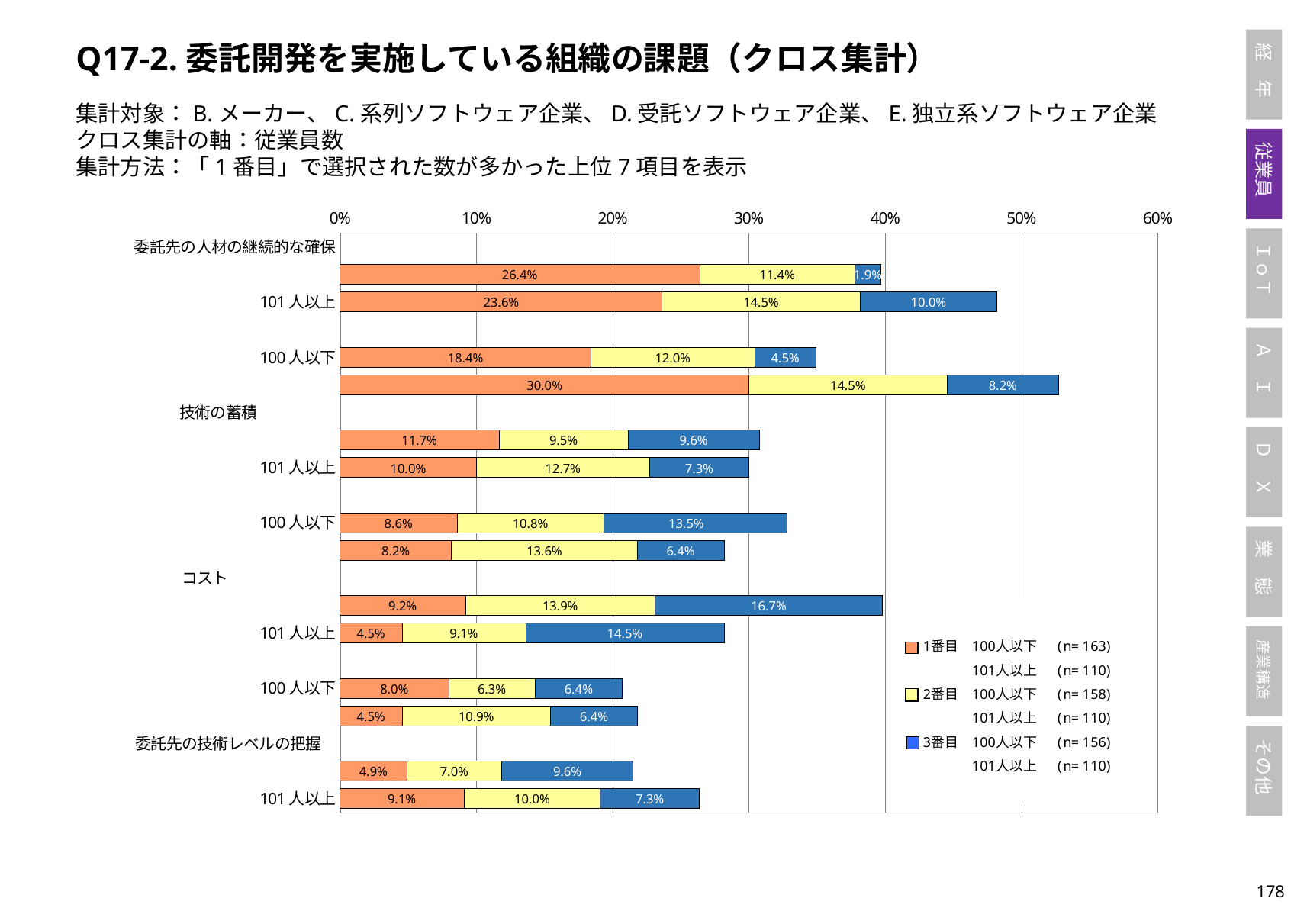
What is the maximum value shown on the horizontal axis? 60% What is the value of the orange (1番目) segment in the topmost bar? 26.4% What kind of chart is shown on the slide? Stacked bar chart What is the total of the bottommost stacked bar (9.1%, 10.0%, 7.3%)? 26.4% What is the largest blue (3番目) segment value shown in the chart? 16.7% What is the total of the second bar from the top (23.6%, 14.5%, 10.0%)? 48.1% What is the largest orange (1番目) segment value shown in the chart? 30.0% How many series does the legend list (1番目, 2番目, 3番目)? 3 What is the total of the topmost stacked bar (26.4%, 11.4%, 1.9%)? 39.7% What is the value of the blue (3番目) segment in the topmost bar? 1.9% What is the difference between the orange segments of the topmost bar (26.4%) and the second bar (23.6%)? 2.8% Which is larger: the yellow segment of the topmost bar (11.4%) or the yellow segment of the second bar (14.5%)? The second bar (14.5%)